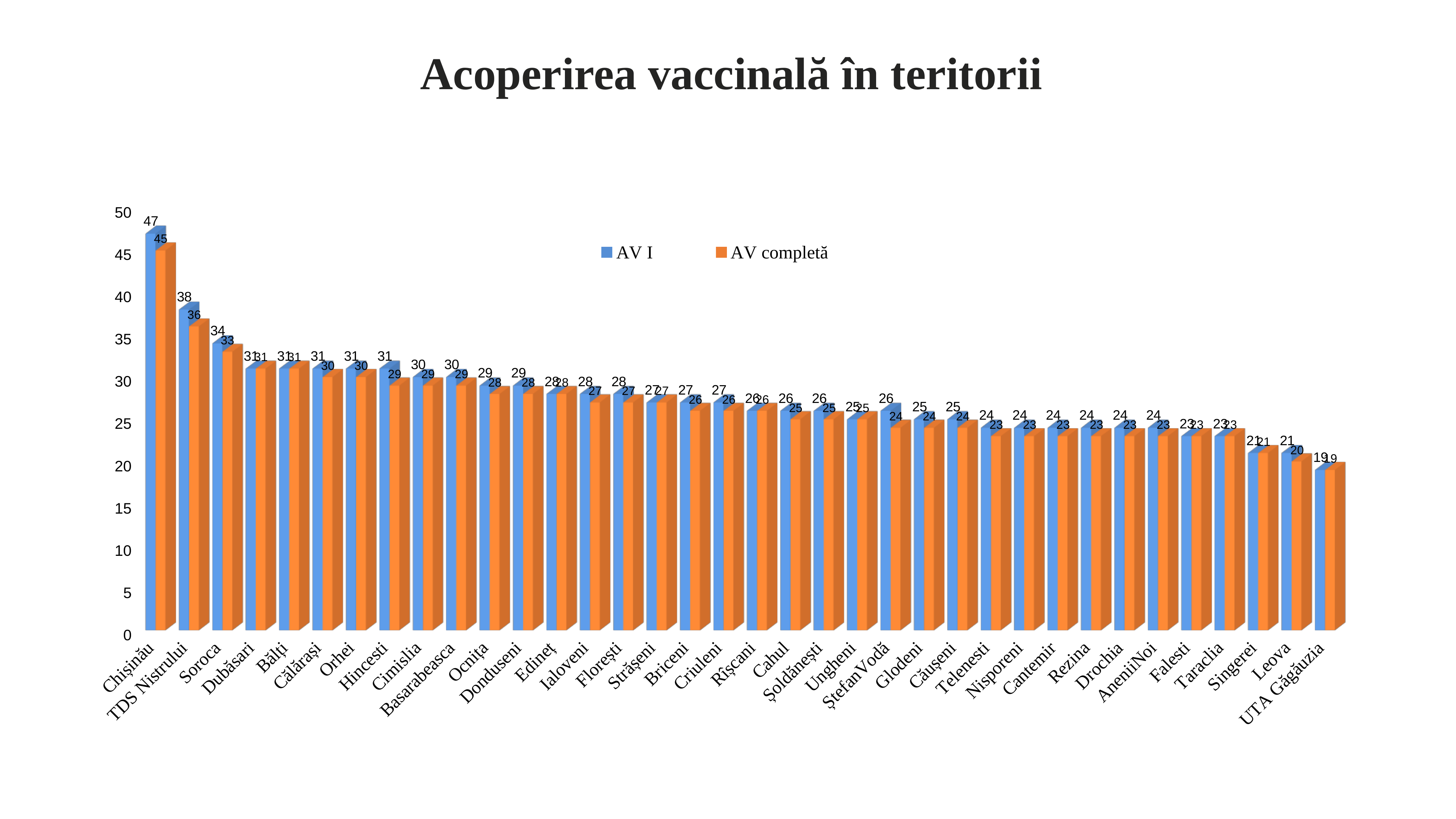
What kind of chart is shown on the slide? Bar chart Which territory has the lowest AV completă value? UTA Găgăuzia What is the difference between the AV I and AV completă values for Chișinău? 2 What is the AV I value for Chișinău? 47 What is the difference between the AV I values for TDS Nistrului and Soroca? 4 How many territories are shown on the x axis? 36 Which territory has the highest AV I value? Chișinău Which is larger, the AV I value for Soroca or the AV I value for Leova? Soroca What is the AV completă value for Soroca? 33 What is the AV completă value for TDS Nistrului? 36 Do the AV I values rise or fall from left to right along the x axis? Fall How many series does the legend list? 2